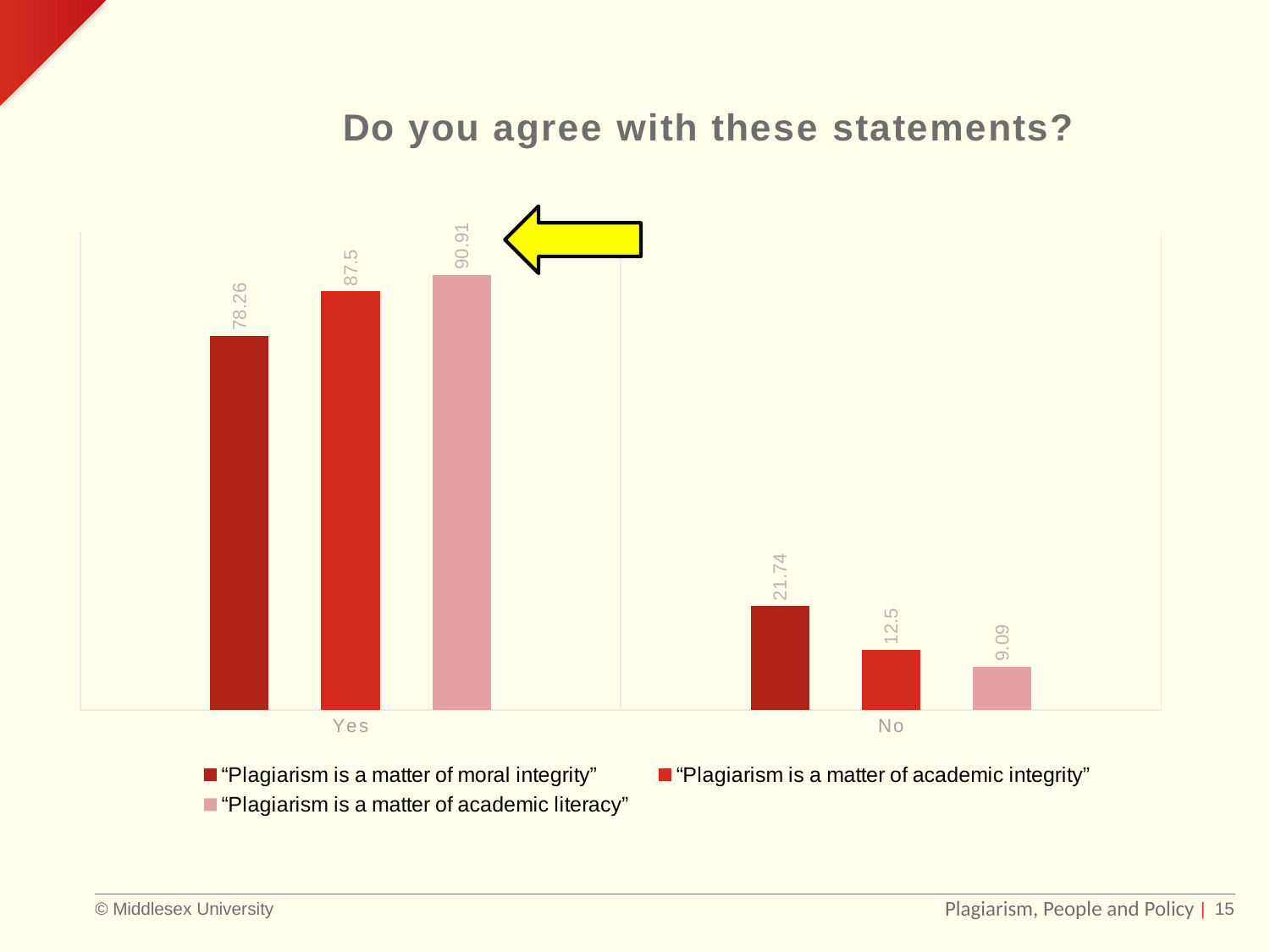
What kind of chart is shown on the slide? Bar chart What is the difference between the Yes values for "Plagiarism is a matter of academic literacy" and "Plagiarism is a matter of moral integrity"? 12.65 What is the value for "Plagiarism is a matter of academic integrity" in the No category? 12.5 What is the value for "Plagiarism is a matter of moral integrity" in the No category? 21.74 Which series has the highest value in the Yes category? "Plagiarism is a matter of academic literacy" What is the value for "Plagiarism is a matter of academic literacy" in the Yes category? 90.91 Which is larger: the No value for "Plagiarism is a matter of moral integrity" or the No value for "Plagiarism is a matter of academic integrity"? "Plagiarism is a matter of moral integrity" What is the value for "Plagiarism is a matter of moral integrity" in the Yes category? 78.26 How many categories are shown on the x axis? 2 What is the title of the chart? Do you agree with these statements? How many series does the legend list? 3 Which series has the lowest value in the No category? "Plagiarism is a matter of academic literacy"